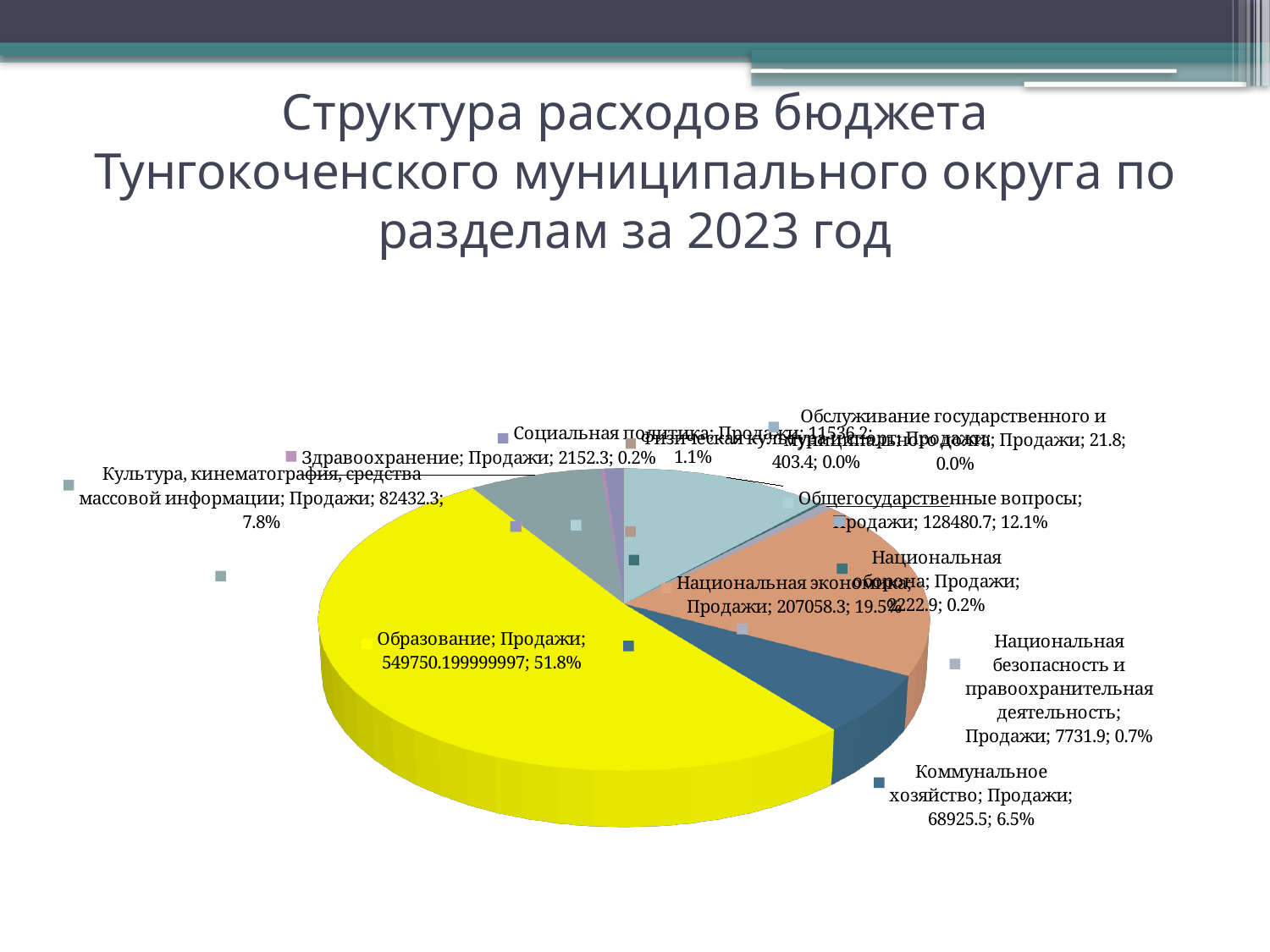
What share of expenditures does Здравоохранение account for? 0.2% Which is larger: the value for Коммунальное хозяйство or the value for Национальная безопасность и правоохранительная деятельность? Коммунальное хозяйство What is the value shown for Культура, кинематография, средства массовой информации? 82432.3 What is the value shown for Обслуживание государственного и муниципального долга? 21.8 What share of expenditures does Общегосударственные вопросы account for? 12.1% What is the value shown for Коммунальное хозяйство? 68925.5 What is the value shown for Национальная экономика? 207058.3 What share of expenditures does Образование account for? 51.8% What kind of chart is shown on the slide? pie chart What is the title of the chart on the slide? Структура расходов бюджета Тунгокоченского муниципального округа по разделам за 2023 год What is the difference between the values for Национальная экономика and Общегосударственные вопросы? 78577.6 Which section has the largest share of budget expenditures? Образование